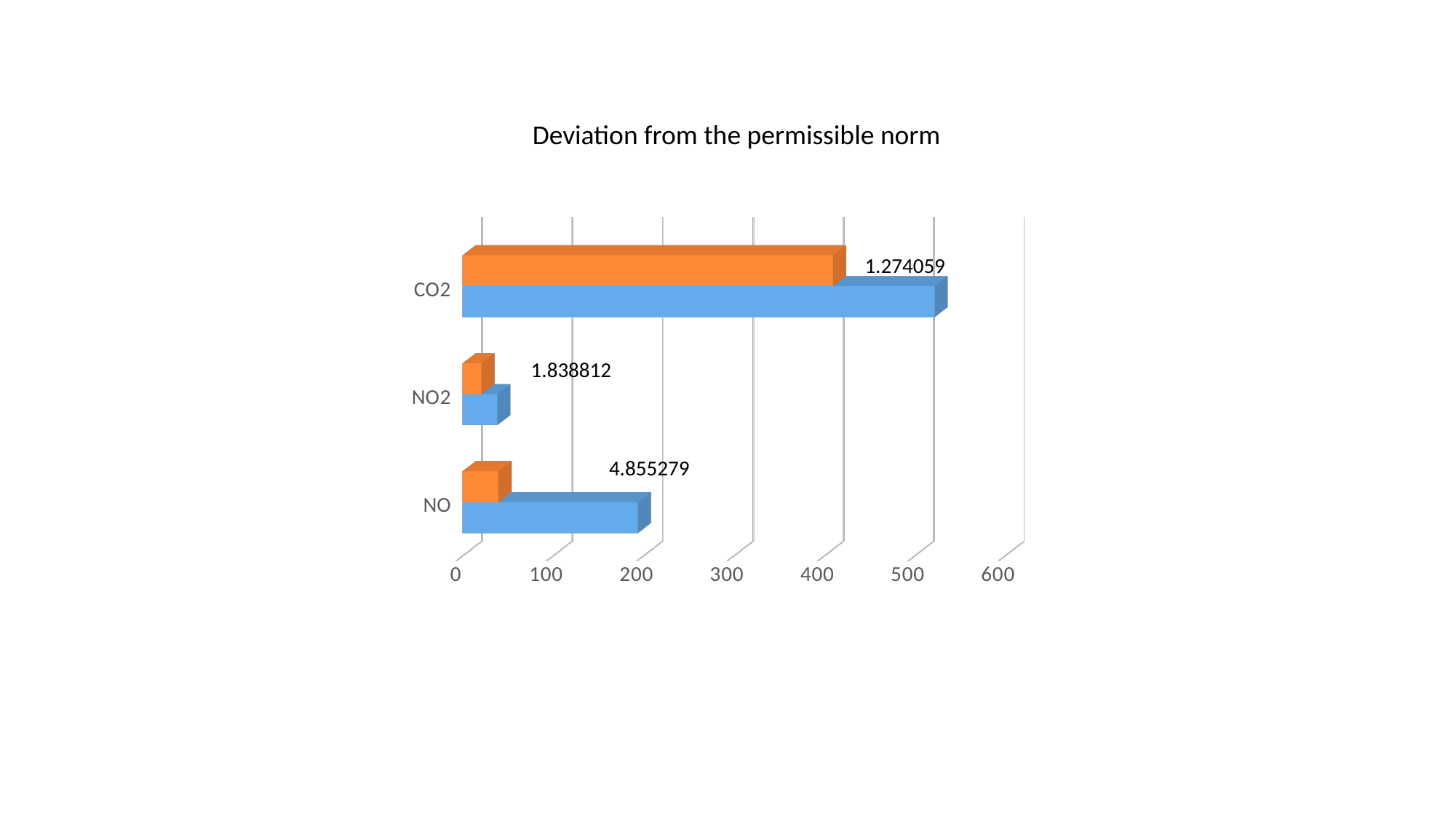
Is the value of the blue bar for NO2 greater or less than 100? less What data label is printed next to the NO2 bars? 1.838812 How many categories are shown on the chart? 3 What data label is printed next to the NO bars? 4.855279 How many data series are plotted on the chart? 2 What is the title of the chart? Deviation from the permissible norm Which category has the shortest blue bar? NO2 Is the value of the blue bar for CO2 greater or less than 400? greater What data label is printed next to the CO2 bars? 1.274059 What kind of chart is shown on the slide? bar chart For NO, which bar is longer, the blue bar or the orange bar? the blue bar Which category has the longest blue bar? CO2